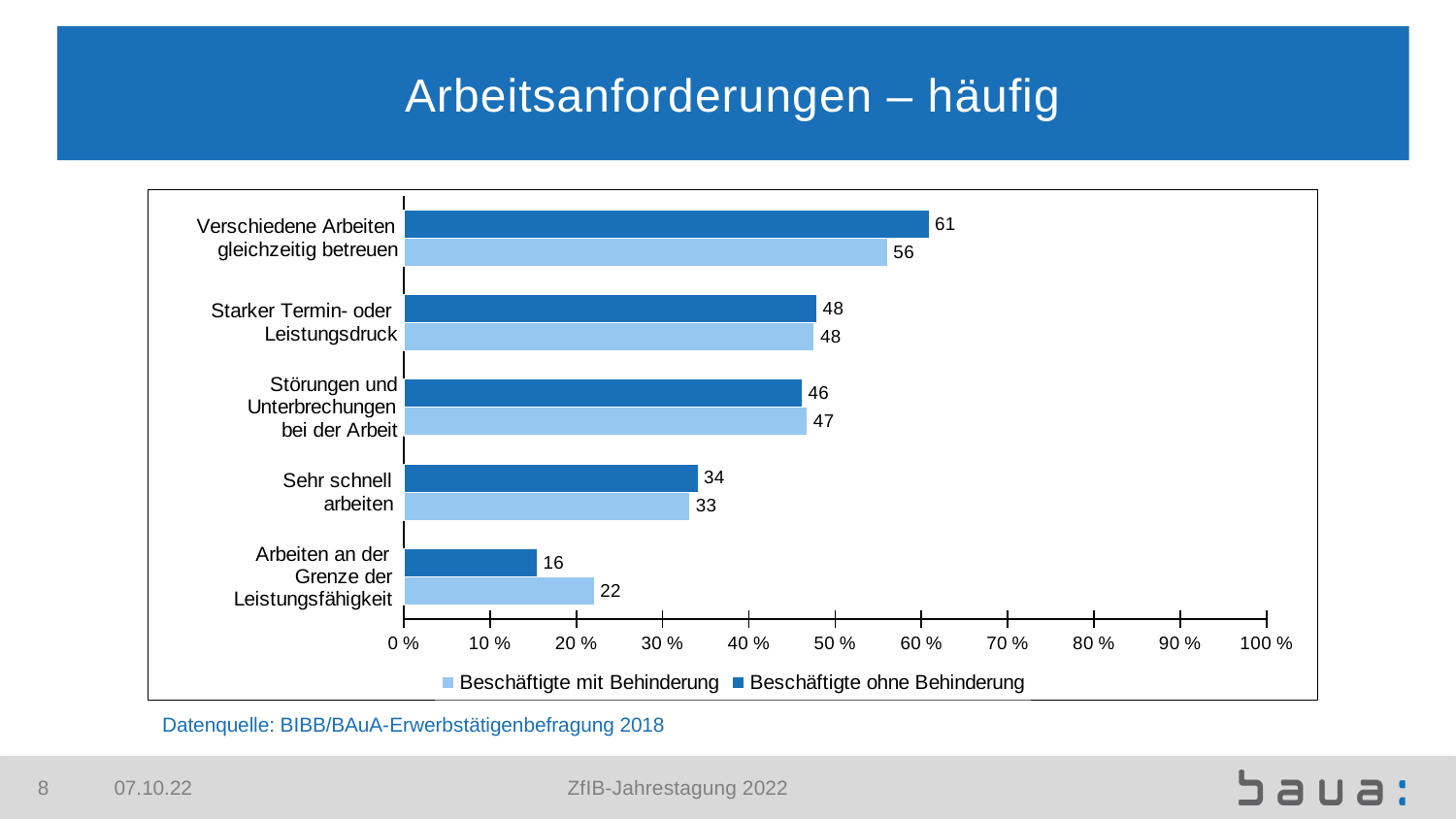
Which category has the lowest value for "Beschäftigte mit Behinderung"? Arbeiten an der Grenze der Leistungsfähigkeit How many categories are shown on the chart? 5 How many series does the legend list? 2 Which category has the highest value for "Beschäftigte ohne Behinderung"? Verschiedene Arbeiten gleichzeitig betreuen Which series is shown in light blue according to the legend? Beschäftigte mit Behinderung What is the value for "Beschäftigte ohne Behinderung" in the category "Verschiedene Arbeiten gleichzeitig betreuen"? 61 Is the value for "Beschäftigte ohne Behinderung" in "Sehr schnell arbeiten" greater or less than 40 %? less In the category "Verschiedene Arbeiten gleichzeitig betreuen", which series has the larger value? Beschäftigte ohne Behinderung What kind of chart is shown on the slide? Bar chart What is the value for "Beschäftigte mit Behinderung" in the category "Arbeiten an der Grenze der Leistungsfähigkeit"? 22 What is the difference between "Beschäftigte mit Behinderung" and "Beschäftigte ohne Behinderung" in the category "Arbeiten an der Grenze der Leistungsfähigkeit"? 6 What is the value for "Beschäftigte mit Behinderung" in the category "Sehr schnell arbeiten"? 33